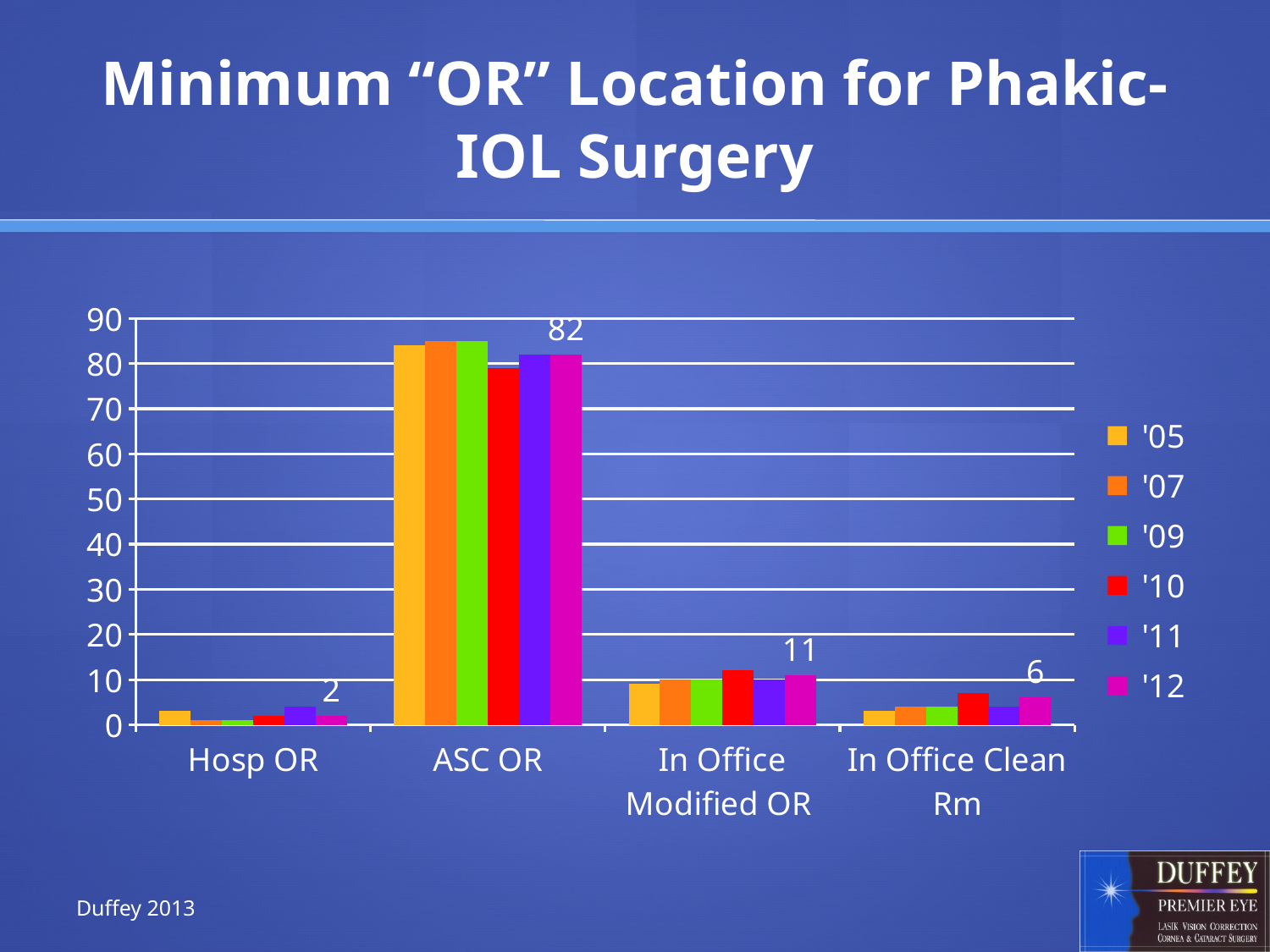
What is the difference between the '12 values for ASC OR and In Office Modified OR? 71 Which is larger for '12: In Office Modified OR or In Office Clean Rm? In Office Modified OR What is the value for '12 in the Hosp OR category? 2 How many series does the legend list? 6 Which category has the highest values across all series? ASC OR What is the value for '12 in the In Office Modified OR category? 11 What is the value for '12 in the ASC OR category? 82 How many categories are shown on the x axis? 4 What is the title of the chart? Minimum "OR" Location for Phakic-IOL Surgery What type of chart is shown on the slide? bar chart Is the value for '05 in the ASC OR category greater or less than 80? greater What is the value for '12 in the In Office Clean Rm category? 6